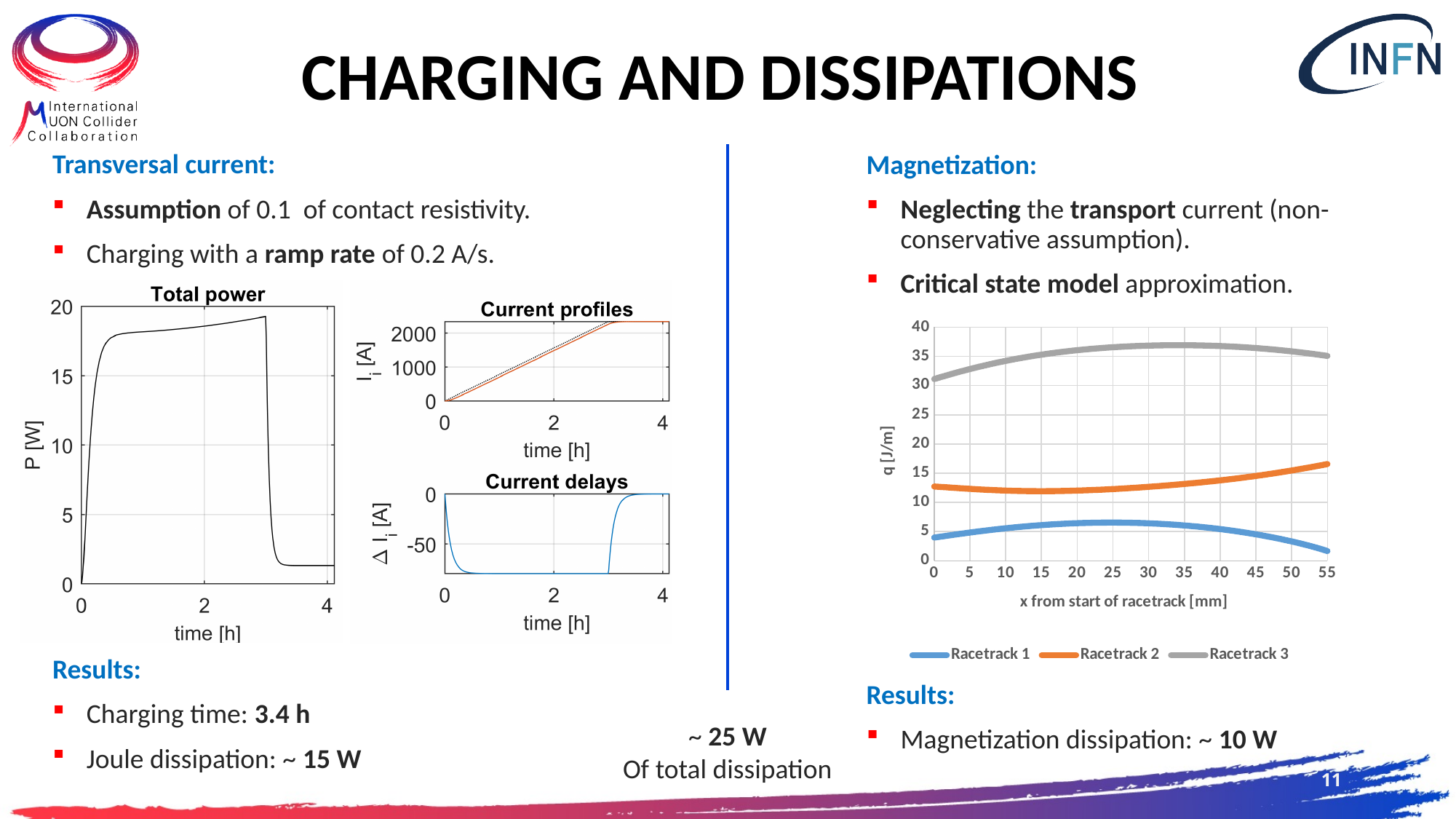
In the "Total power" chart, is the value of P at time 4 h greater or less than 5? less In the chart on the right with x from start of racetrack [mm], is the value of Racetrack 3 at x = 0 greater or less than 25? greater In the chart on the right with x from start of racetrack [mm], which series has the lowest values? Racetrack 1 In the chart on the right with x from start of racetrack [mm], at x = 30, which is larger: Racetrack 3 or Racetrack 2? Racetrack 3 In the "Total power" chart, is the value of P at time 2 h greater or less than 15? greater In the chart on the right with x from start of racetrack [mm], does Racetrack 2 rise or fall between x = 15 and x = 55? rise In the chart on the right with x from start of racetrack [mm], which series has the highest values? Racetrack 3 How many series does the legend of the magnetization chart on the right (x from start of racetrack) list? 3 What kind of chart is the chart titled "Total power"? line chart What is the y-axis label of the "Total power" chart? P [W]